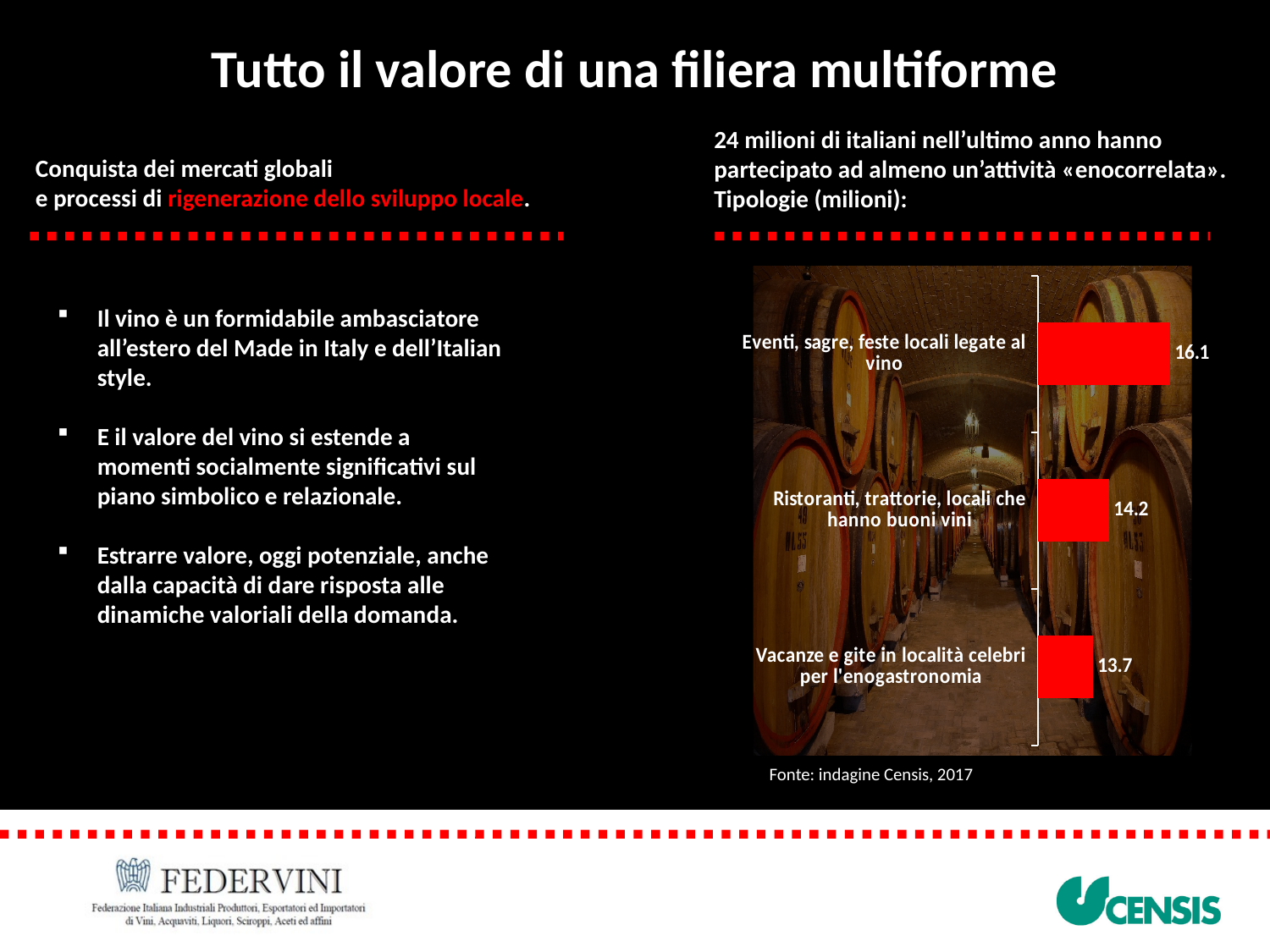
Which is larger: the value for "Eventi, sagre, feste locali legate al vino" or for "Ristoranti, trattorie, locali che hanno buoni vini"? Eventi, sagre, feste locali legate al vino What is the value for "Eventi, sagre, feste locali legate al vino"? 16.1 What is the value for "Ristoranti, trattorie, locali che hanno buoni vini"? 14.2 What kind of chart is shown on the slide? Bar chart Which category has the lowest value? Vacanze e gite in località celebri per l'enogastronomia How many categories are shown in the chart? 3 What is the value for "Vacanze e gite in località celebri per l'enogastronomia"? 13.7 What is the source cited below the chart? Fonte: indagine Censis, 2017 What is the difference between the values for "Ristoranti, trattorie, locali che hanno buoni vini" and "Vacanze e gite in località celebri per l'enogastronomia"? 0.5 Which category has the highest value? Eventi, sagre, feste locali legate al vino What is the difference between the values for "Eventi, sagre, feste locali legate al vino" and "Vacanze e gite in località celebri per l'enogastronomia"? 2.4 What colour are the bars in the chart? Red